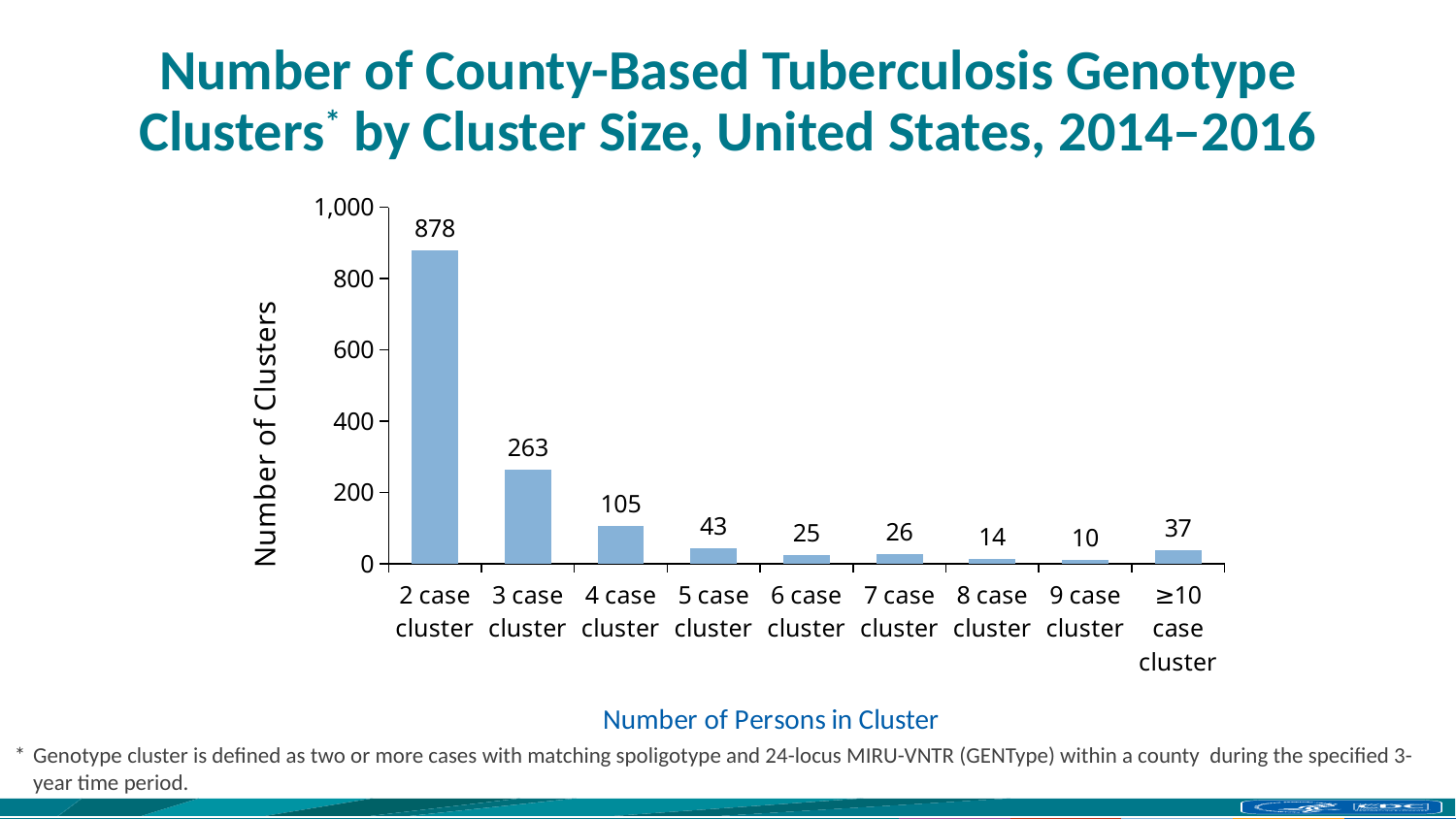
What is the number of clusters for the 4 case cluster category? 105 What kind of chart is shown on the slide? Bar chart What is the value for the ≥10 case cluster category? 37 Which has more clusters, the 7 case cluster category or the 8 case cluster category? 7 case cluster What is the difference between the number of 5 case clusters and 6 case clusters? 18 What is the label of the y axis? Number of Clusters Which cluster size category has the highest number of clusters? 2 case cluster What is the label of the x axis? Number of Persons in Cluster Which cluster size category has the lowest number of clusters? 9 case cluster How many cluster size categories are shown on the x axis? 9 How many clusters are shown for the 2 case cluster category? 878 What is the difference between the number of 2 case clusters and 3 case clusters? 615